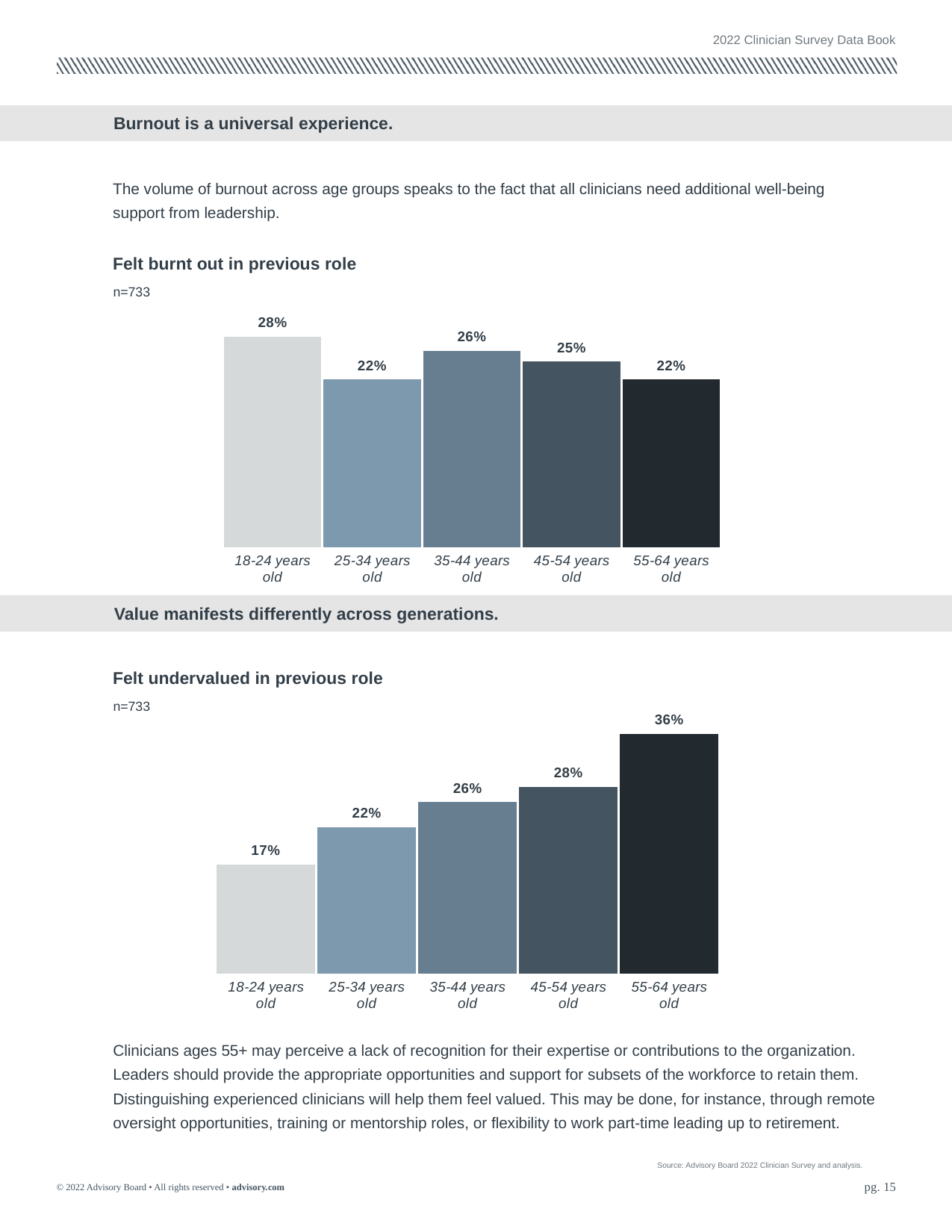
What type of chart is the 'Felt undervalued in previous role' chart? Bar chart In the 'Felt burnt out in previous role' chart, what is the value for 45-54 years old? 25% In the 'Felt undervalued in previous role' chart, what is the difference between the 55-64 years old and 18-24 years old values? 19% In the 'Felt burnt out in previous role' chart, what is the value for 18-24 years old? 28% In the 'Felt undervalued in previous role' chart, what is the value for 55-64 years old? 36% In the 'Felt undervalued in previous role' chart, do the values rise or fall from the youngest to the oldest age group? rise In the 'Felt burnt out in previous role' chart, how many age groups are shown? 5 In the 'Felt undervalued in previous role' chart, which age group has the lowest value? 18-24 years old Which is larger: the 35-44 years old value in the 'Felt burnt out in previous role' chart or the 35-44 years old value in the 'Felt undervalued in previous role' chart? They are equal (26%) In the 'Felt burnt out in previous role' chart, what is the difference between the 18-24 years old and 35-44 years old values? 2% In the 'Felt undervalued in previous role' chart, what is the value for 18-24 years old? 17% In the 'Felt burnt out in previous role' chart, which age group has the highest value? 18-24 years old